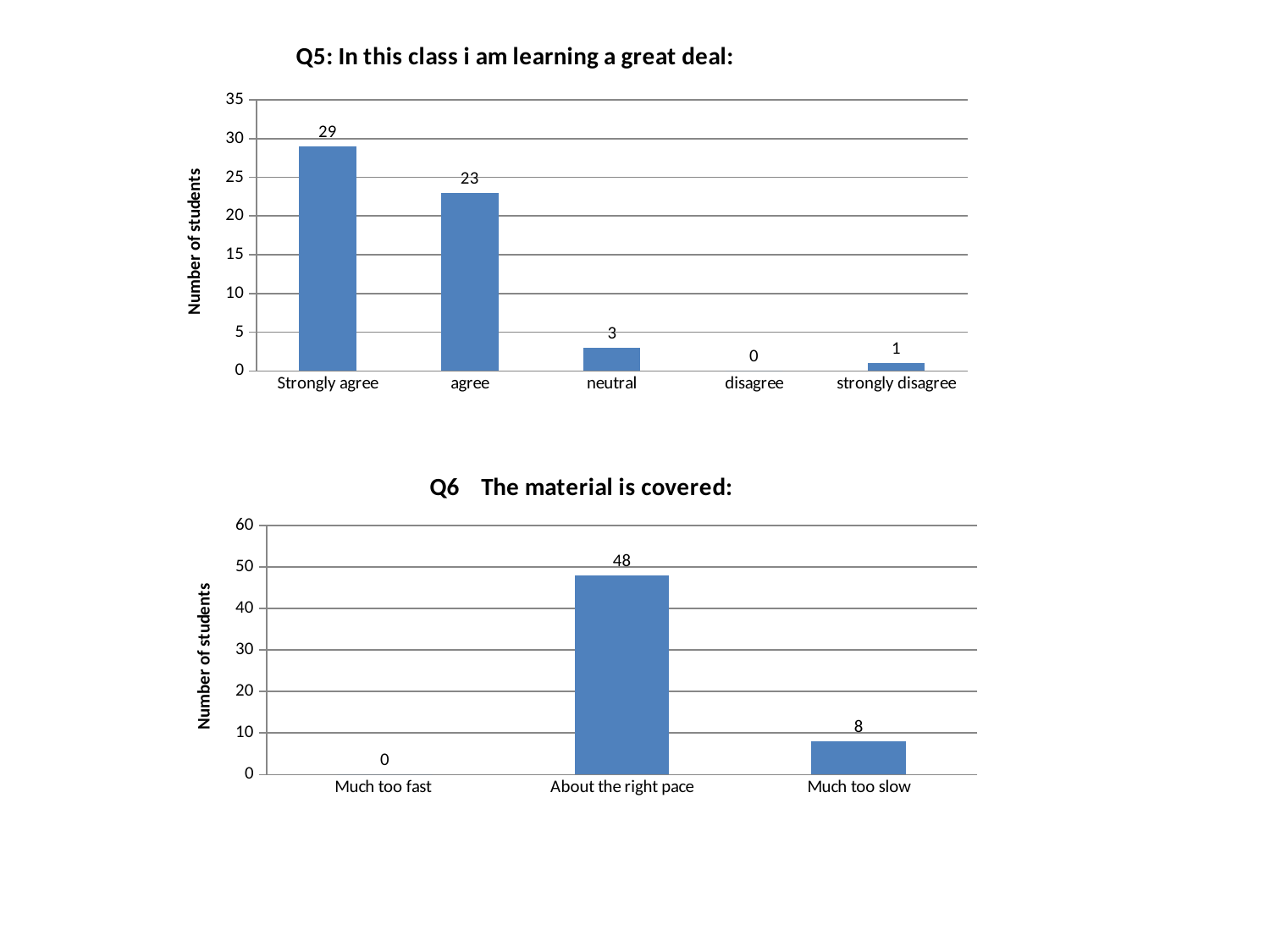
In the Q5 chart (top), what is the label of the y axis? Number of students In the Q5 chart (top), which category has the lowest number of students? disagree In the Q5 chart (top), which category has the highest number of students? Strongly agree In the Q5 chart (top), what is the difference between the number of students who chose 'Strongly agree' and those who chose 'agree'? 6 In the Q5 chart (top), how many categories are shown on the x axis? 5 In the Q6 chart (bottom), what is the difference between 'About the right pace' and 'Much too slow'? 40 What kind of chart is the Q6 chart (bottom)? Bar chart In the Q6 chart (bottom), how many students chose 'About the right pace'? 48 In the Q6 chart (bottom), which category has the lowest number of students? Much too fast In the Q5 chart (top), how many students chose 'neutral'? 3 In the Q6 chart (bottom), how many students chose 'Much too slow'? 8 In the Q5 chart (top), how many students chose 'Strongly agree'? 29